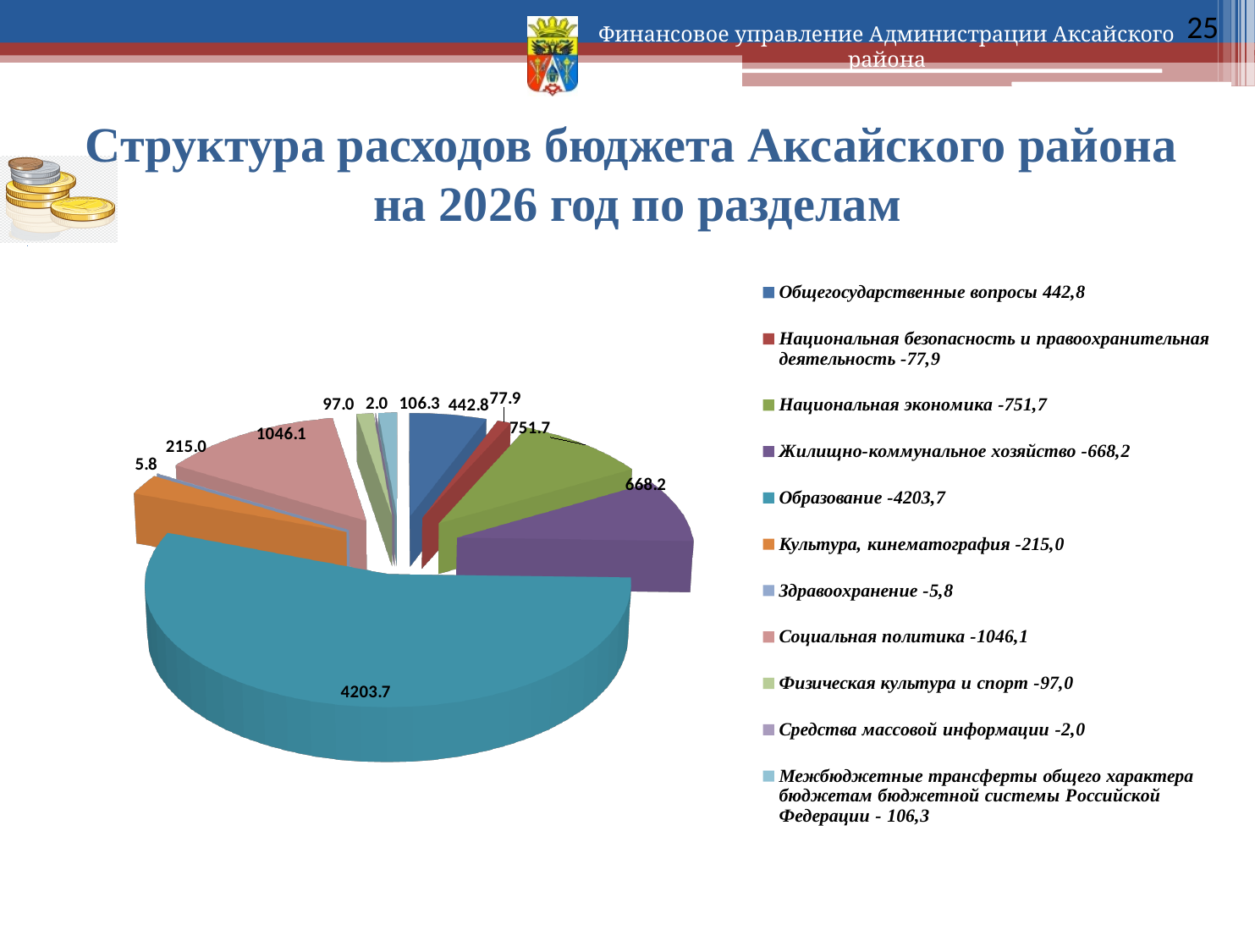
What is the title of the slide containing the chart? Структура расходов бюджета Аксайского района на 2026 год по разделам How many categories does the pie chart have? 11 What is the difference between the values for Социальная политика and Национальная экономика? 294.4 What type of chart is shown on the slide? Pie chart What is the value for Образование? 4203.7 Which category has the smallest value in the pie chart? Средства массовой информации Which category has the largest value in the pie chart? Образование What is the value for Жилищно-коммунальное хозяйство? 668.2 What is the value for Культура, кинематография? 215.0 What is the value for Социальная политика? 1046.1 Which is larger, the value for Национальная экономика or the value for Жилищно-коммунальное хозяйство? Национальная экономика What is the difference between the values for Общегосударственные вопросы and Культура, кинематография? 227.8